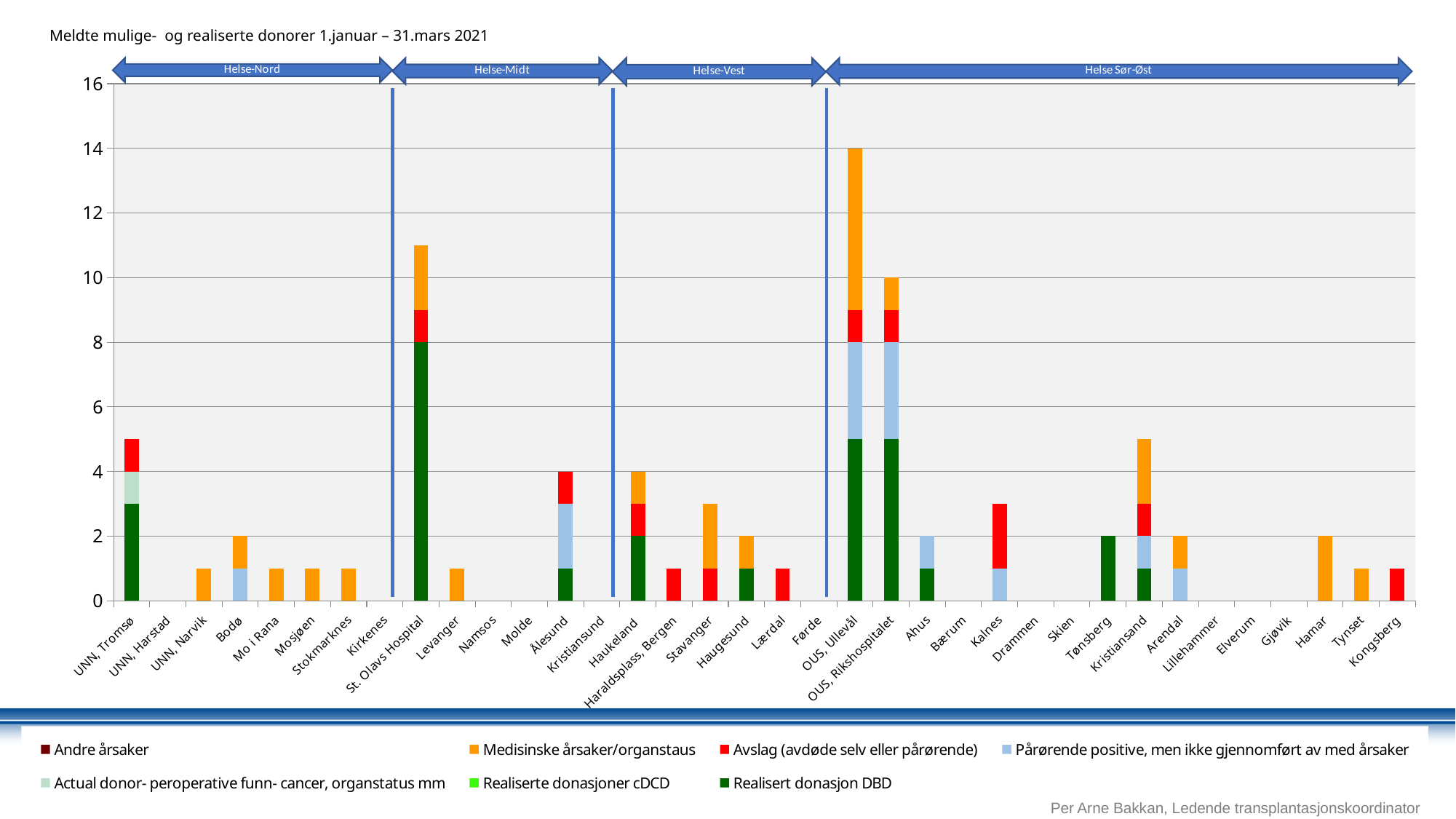
How many hospitals are listed along the x axis? 36 Is the total bar for Kristiansand greater or less than 4? greater What is the total height of the bar for OUS, Rikshospitalet? 10 Which has the taller total bar, Ålesund or Stavanger? Ålesund Which hospital has the highest total bar? OUS, Ullevål Is the total bar for St. Olavs Hospital greater or less than 10? greater How many series does the legend list? 7 Which has the taller total bar, OUS, Ullevål or St. Olavs Hospital? OUS, Ullevål What kind of chart is shown on the slide? Stacked bar chart What is the title of the chart? Meldte mulige- og realiserte donorer 1.januar – 31.mars 2021 What is the difference between the total bars for OUS, Ullevål and OUS, Rikshospitalet? 4 What is the total height of the bar for OUS, Ullevål? 14